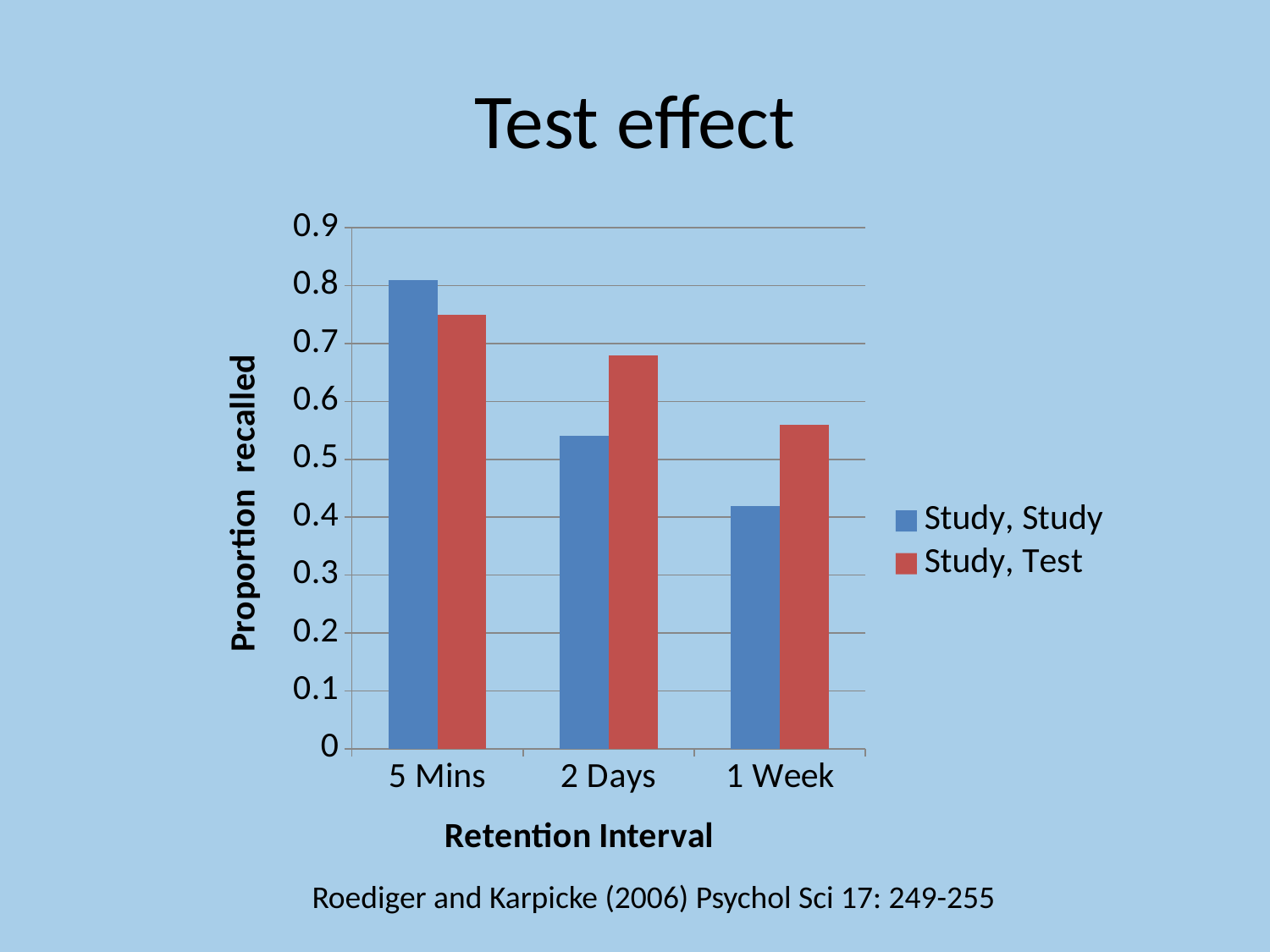
Is the Study, Study value at 1 Week greater or less than 0.5? less How many retention intervals are shown on the x axis? 3 Is the Study, Test value at 2 Days greater or less than 0.6? greater What kind of chart is shown on the slide? bar chart At 5 Mins, which series has the larger value, Study, Study or Study, Test? Study, Study Is the Study, Study value at 5 Mins greater or less than 0.7? greater How many series does the legend list? 2 Do the Study, Study values rise or fall as the retention interval increases from 5 Mins to 1 Week? fall At which retention interval is the Study, Study value lowest? 1 Week What is the title of the vertical axis? Proportion recalled At 1 Week, which series has the larger value, Study, Study or Study, Test? Study, Test